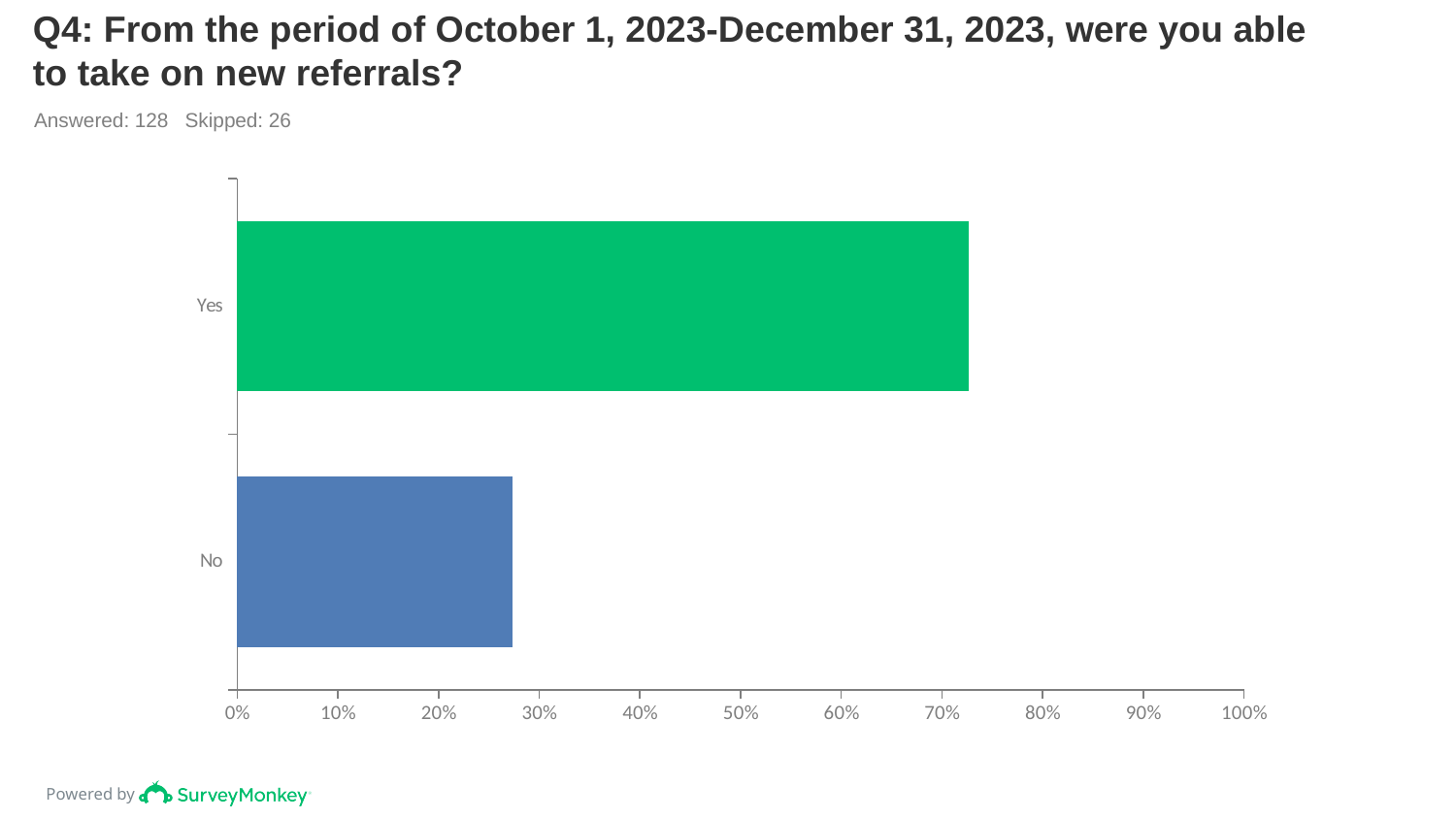
Is the value for No greater or less than 20%? greater Which category has the lowest value? No What is the maximum value shown on the x axis? 100% Is the value for Yes greater or less than 80%? less Which is larger, the value for Yes or the value for No? Yes Which category has the highest value? Yes What kind of chart is shown on the slide? bar chart How many categories are plotted in the chart? 2 Is the value for Yes greater or less than 70%? greater How many respondents answered this question, according to the slide? 128